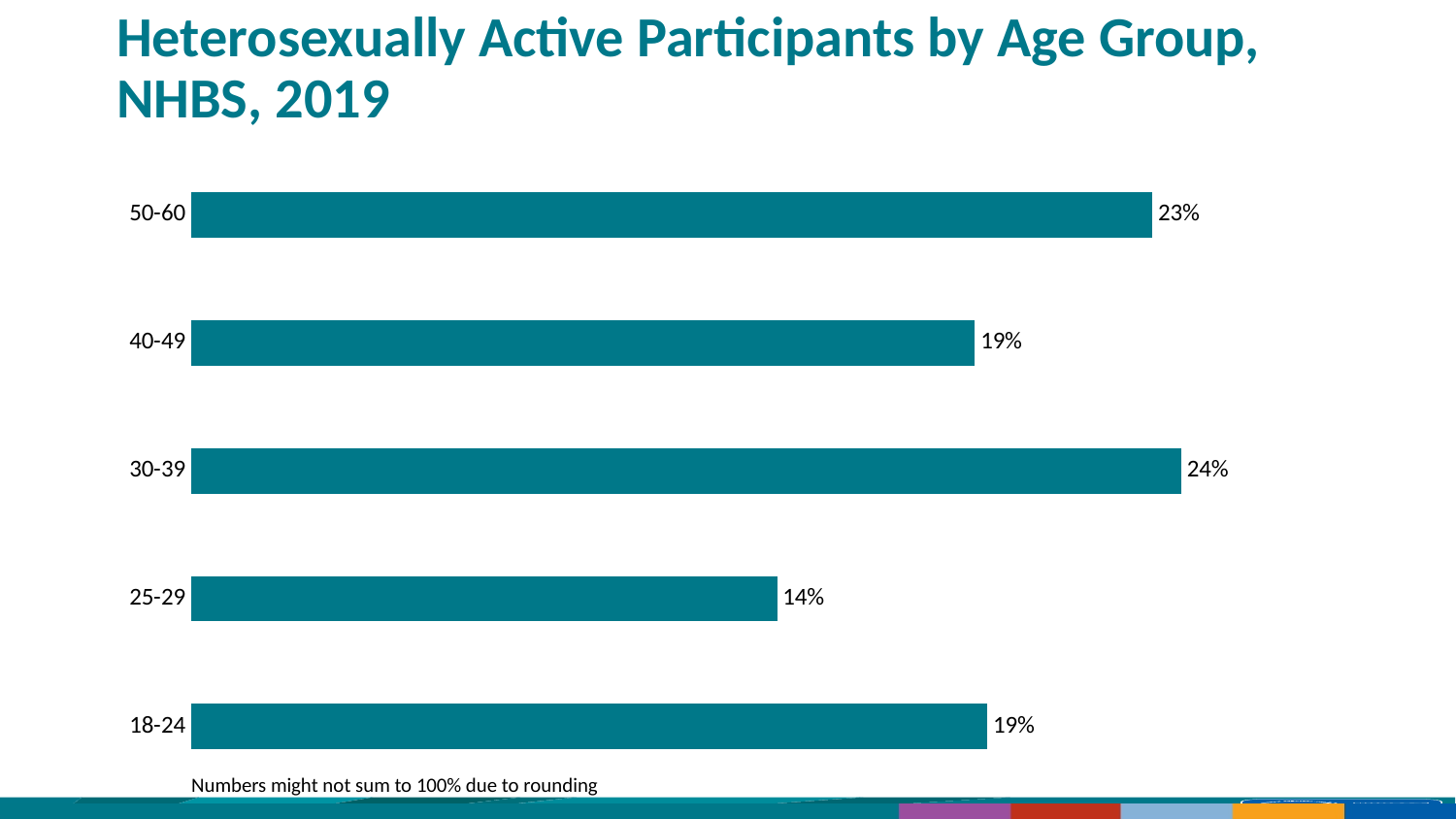
What is the difference in percentage points between the 30-39 and 25-29 age groups? 10 What is the title of the chart on the slide? Heterosexually Active Participants by Age Group, NHBS, 2019 What percentage is shown for the 30-39 age group? 24% What is the value shown for the 25-29 age group? 14% How many age groups are shown in the chart? 5 What is the value for the 18-24 age group? 19% Which age group has a larger share, 50-60 or 25-29? 50-60 What is the difference in percentage points between the 50-60 and 40-49 age groups? 4 What percentage of heterosexually active participants were in the 50-60 age group? 23% Which age group has the lowest percentage of heterosexually active participants? 25-29 Which age group has the highest percentage of heterosexually active participants? 30-39 What type of chart is shown on the slide? Bar chart